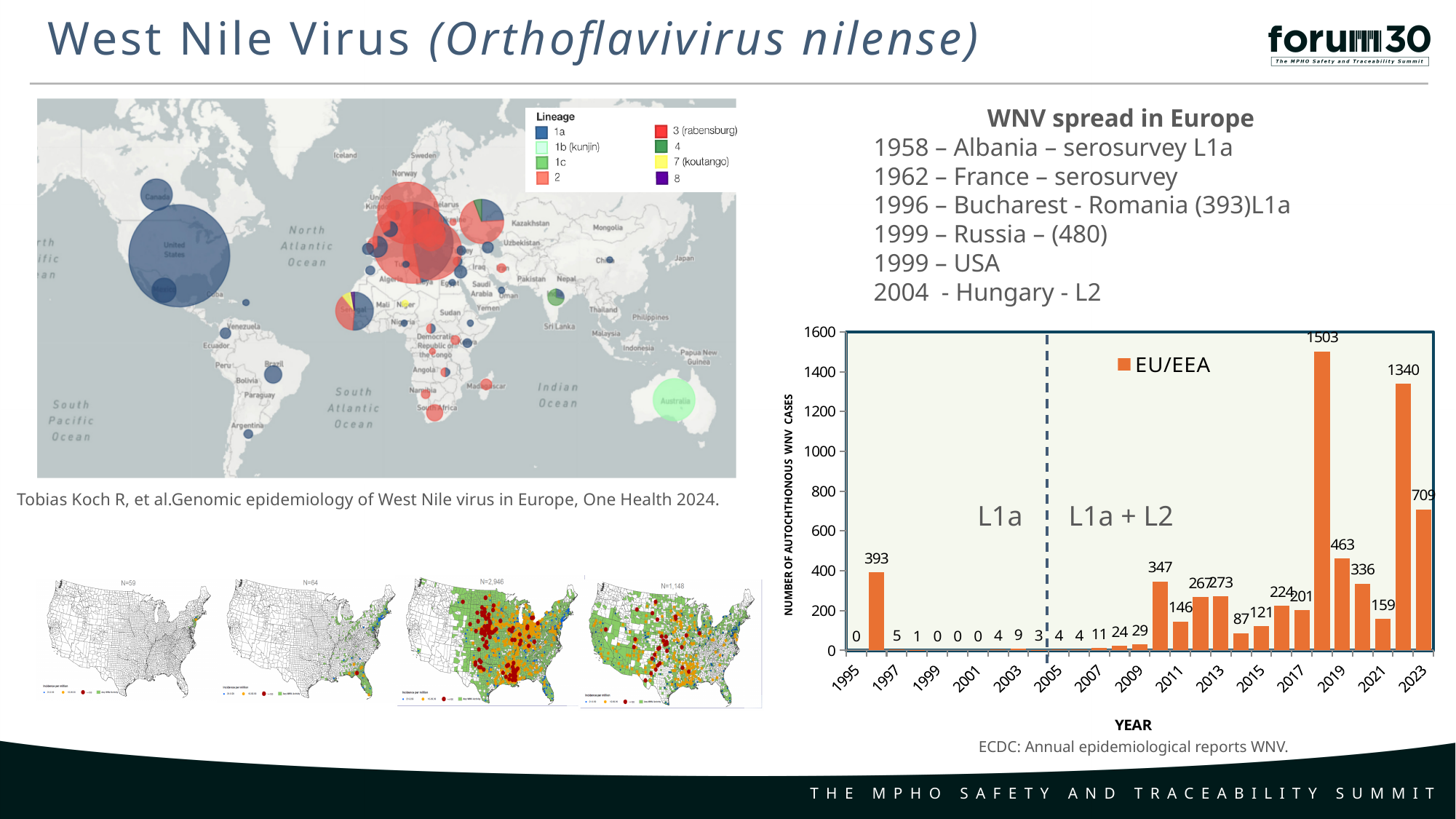
What series name is shown in the legend of the bar chart? EU/EEA What is the label of the y axis of the bar chart? NUMBER OF AUTOCHTHONOUS WNV CASES In the bar chart, what is the value of the tallest bar? 1503 In the bar chart, what is the number of autochthonous WNV cases in 2023? 709 In the bar chart, what is the number of autochthonous WNV cases in 2009? 29 What kind of chart is shown at the bottom right of the slide? bar chart In the bar chart, what is the number of autochthonous WNV cases in 2011? 146 In the bar chart, what is the difference between the 2023 value and the 2021 value? 550 How many series does the legend of the bar chart list? 1 In the bar chart, which year has more cases, 2013 or 2015? 2013 In the bar chart, is the value for 2019 greater or less than 400? greater In the bar chart, what is the number of autochthonous WNV cases in 2019? 463